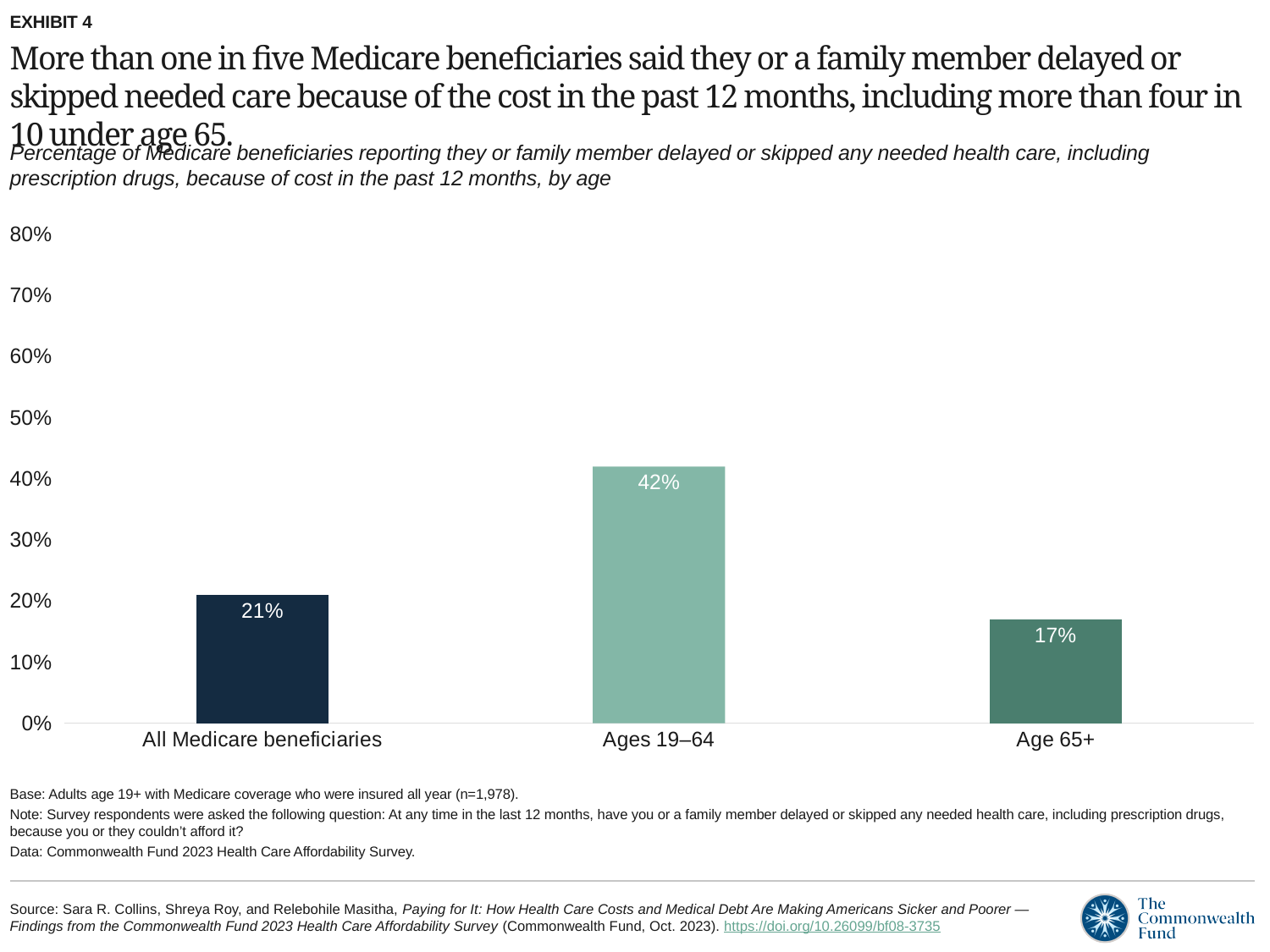
Which category has the lowest value? Age 65+ What percentage is shown for Age 65+? 17% Which category has the highest value? Ages 19–64 What percentage is shown for Ages 19–64? 42% What is the difference between the values for Ages 19–64 and Age 65+? 25 percentage points How many categories are shown on the x axis? 3 What is the highest value shown on the y axis? 80% What percentage is shown for All Medicare beneficiaries? 21% Is the value for Ages 19–64 greater or less than 40%? greater What kind of chart is shown on the slide? Bar chart What is the difference between the values for All Medicare beneficiaries and Age 65+? 4 percentage points Which is larger, the value for All Medicare beneficiaries or the value for Age 65+? All Medicare beneficiaries